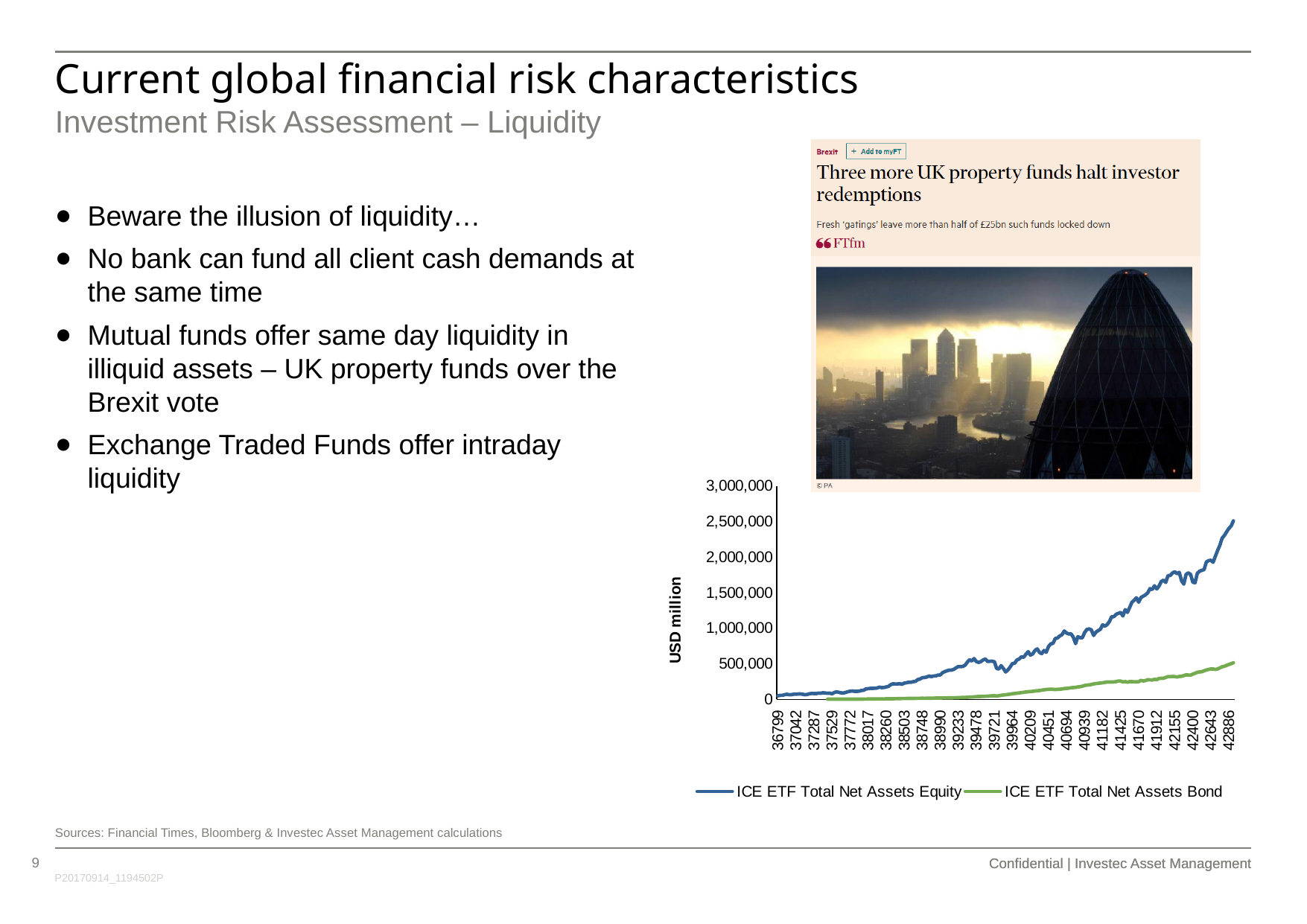
Which series reaches the higher value at the right-hand end of the chart, ICE ETF Total Net Assets Equity or ICE ETF Total Net Assets Bond? ICE ETF Total Net Assets Equity Does the ICE ETF Total Net Assets Equity series rise or fall overall from left to right along the x axis? Rise Is the value of ICE ETF Total Net Assets Equity at the left-hand end of the chart (36799) greater or less than 500,000? less What are the two series named in the chart's legend? ICE ETF Total Net Assets Equity and ICE ETF Total Net Assets Bond Is the value of ICE ETF Total Net Assets Equity at the right-hand end of the chart (42886) greater or less than 2,000,000? greater How many series does the chart's legend list? 2 What kind of chart is shown on the slide? Line chart Does the ICE ETF Total Net Assets Bond series rise or fall overall from left to right along the x axis? Rise What is the title of the chart's vertical axis? USD million Which series reaches the highest value anywhere on the chart? ICE ETF Total Net Assets Equity Is the value of ICE ETF Total Net Assets Bond at the right-hand end of the chart (42886) greater or less than 1,000,000? less